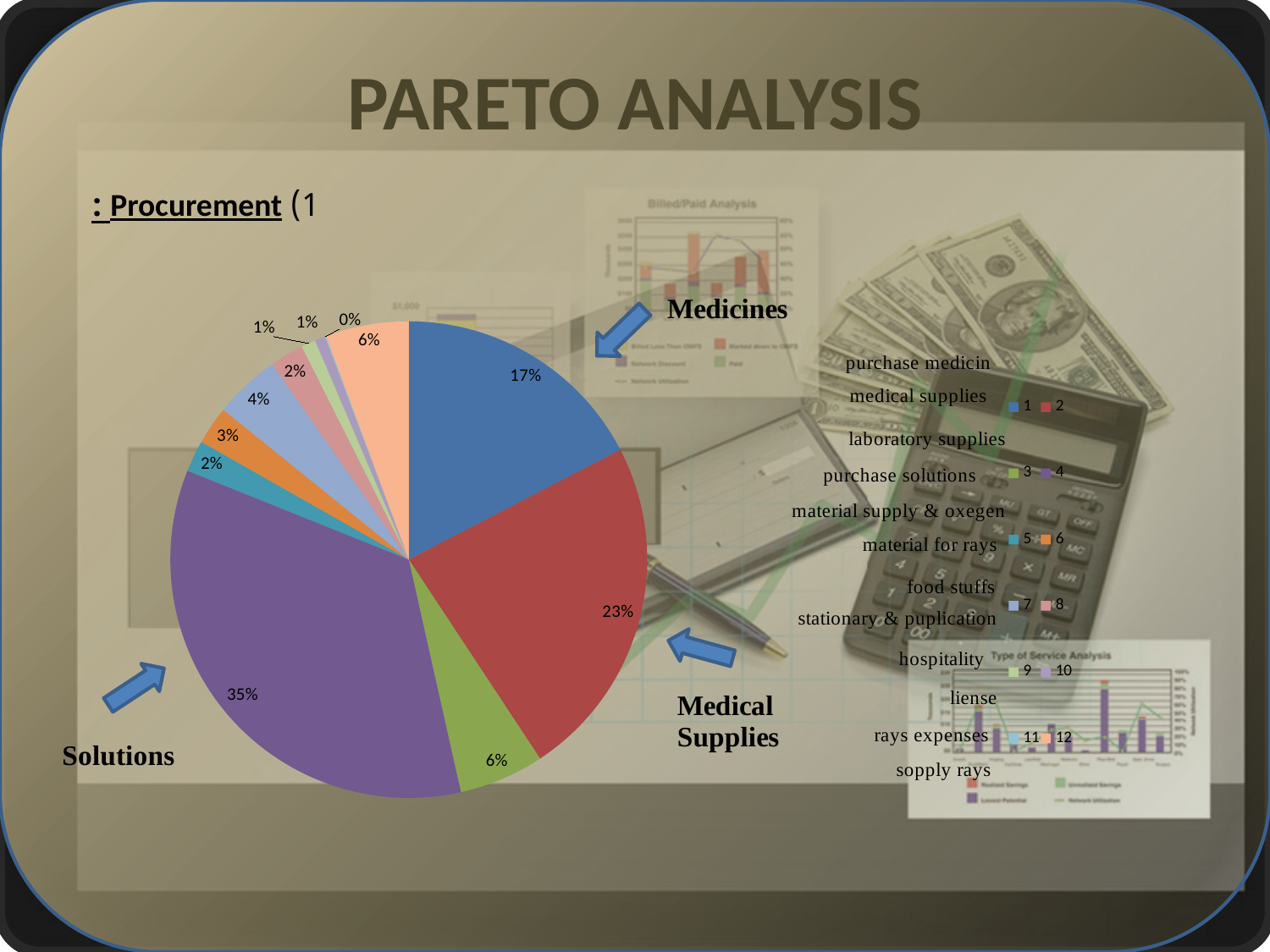
What is the title at the top of the slide? PARETO ANALYSIS What is the difference in percentage points between the "Medical Supplies" slice and the "Medicines" slice? 6 percentage points What colour is the slice labelled 35%? purple What percentage of the pie is labelled for the slice marked "Medical Supplies"? 23% How many numbered entries does the pie chart legend list? 12 What is the smallest percentage label shown on the pie chart? 0% What is the difference in percentage points between the "Solutions" slice and the "Medical Supplies" slice? 12 percentage points What percentage of the pie is labelled for the slice marked "Medicines"? 17% Which labelled slice has the largest share of the pie? Solutions (35%) What kind of chart is shown on the slide? pie chart Which slice is larger, "Medicines" or "Medical Supplies"? Medical Supplies What percentage of the pie is labelled for the slice marked "Solutions"? 35%